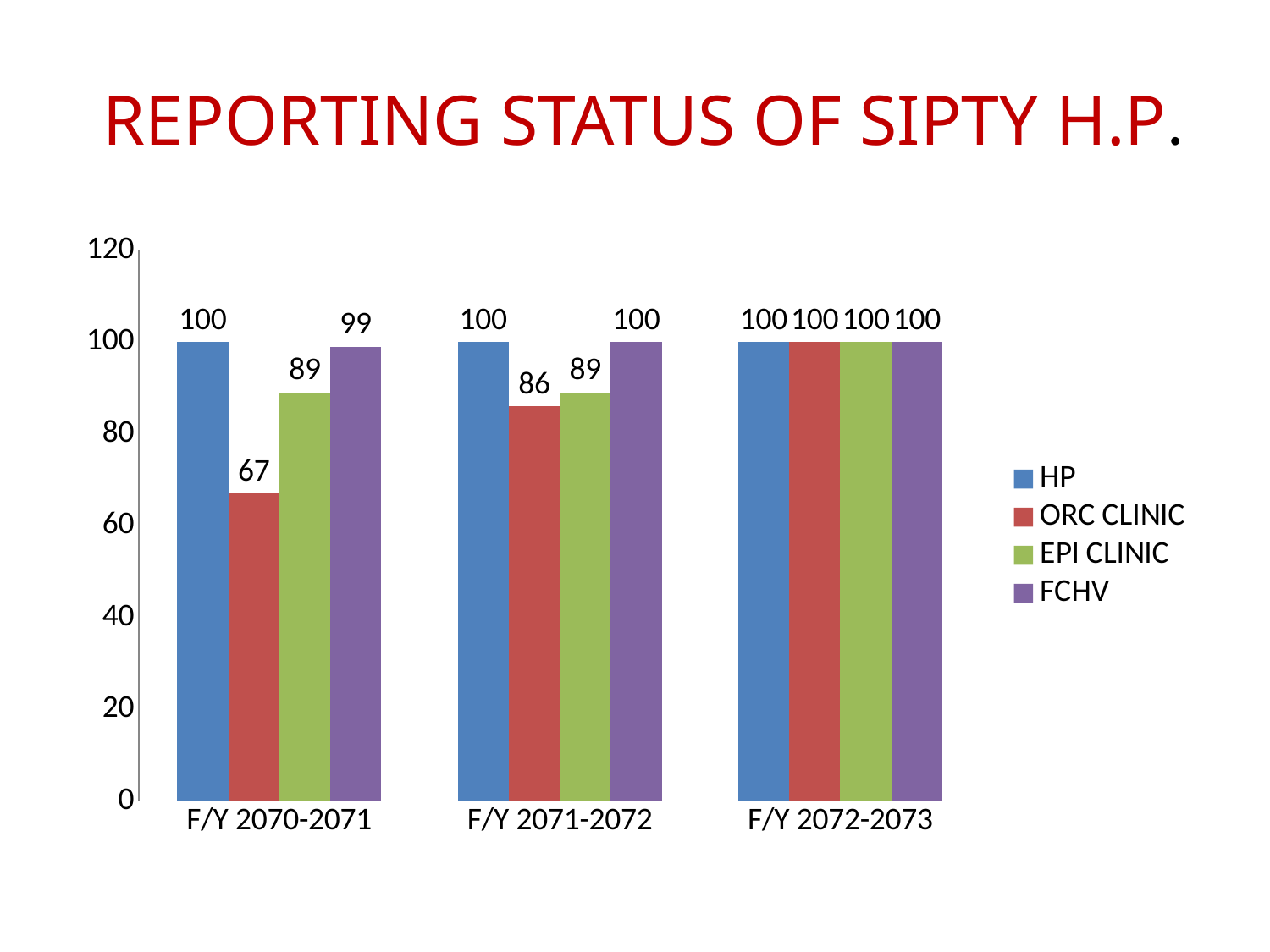
How many series does the legend list? 4 What is the value for ORC CLINIC in F/Y 2070-2071? 67 What kind of chart is shown on the slide? Bar chart What is the value for ORC CLINIC in F/Y 2071-2072? 86 How many fiscal year categories are shown on the x axis? 3 What is the value for EPI CLINIC in F/Y 2071-2072? 89 What is the value for FCHV in F/Y 2070-2071? 99 What is the difference between the ORC CLINIC values in F/Y 2071-2072 and F/Y 2070-2071? 19 What is the difference between the HP and ORC CLINIC values in F/Y 2070-2071? 33 Does the ORC CLINIC value rise or fall from F/Y 2070-2071 to F/Y 2072-2073? Rise Which is larger in F/Y 2071-2072, ORC CLINIC or EPI CLINIC? EPI CLINIC Which series has the lowest value in F/Y 2070-2071? ORC CLINIC